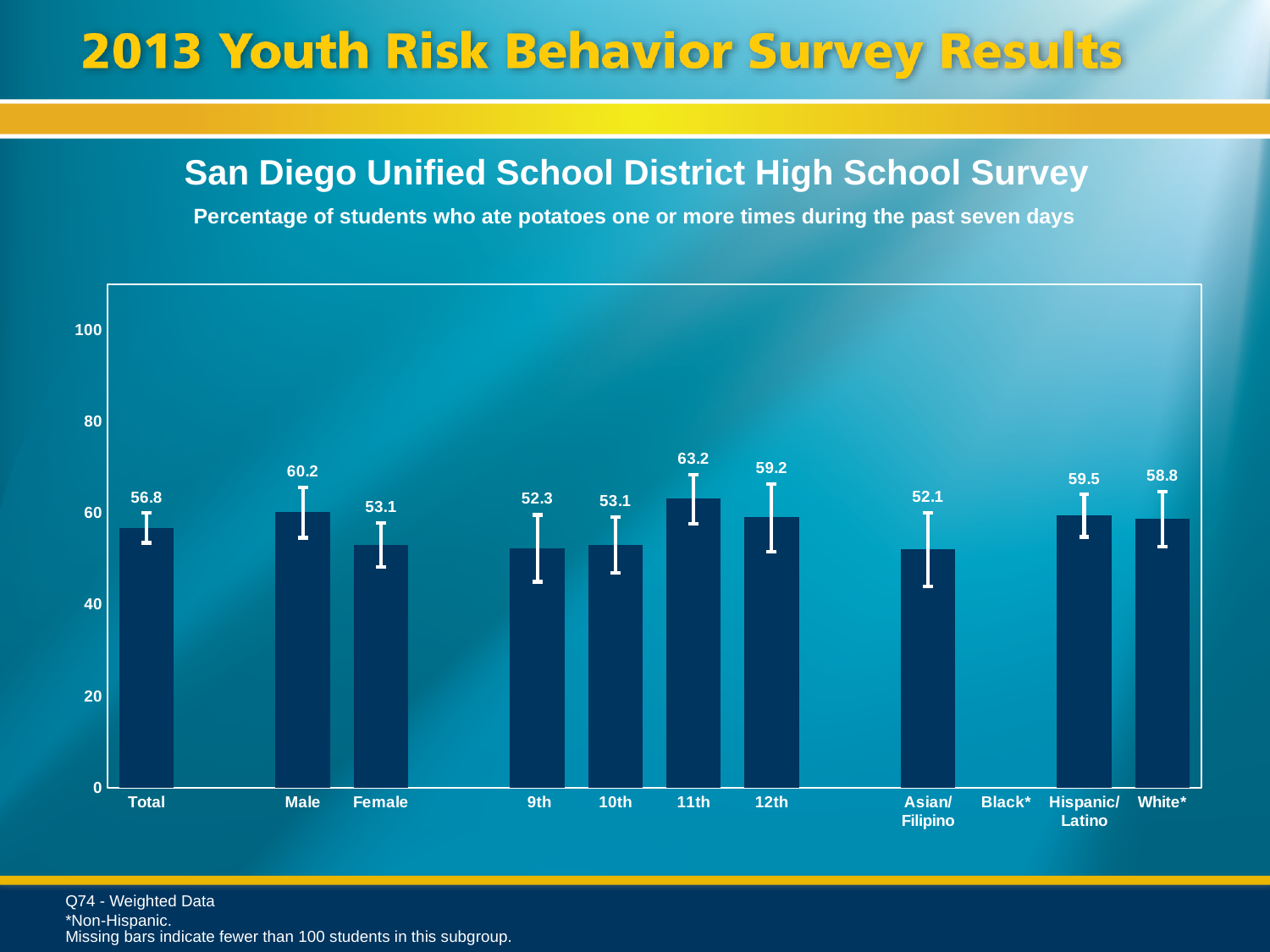
Which category has no bar shown? Black* Which category has the lowest plotted value? Asian/Filipino What kind of chart is shown? bar chart Is the value for 12th grade greater or less than 40? greater Which category has the highest value? 11th Which is larger, the value for Hispanic/Latino or the value for White*? Hispanic/Latino How many categories have a bar plotted? 10 What is the value for Asian/Filipino? 52.1 What is the value for Male? 60.2 What is the value for Total? 56.8 What is the difference between the Male and Female values? 7.1 What is the value for 11th grade? 63.2